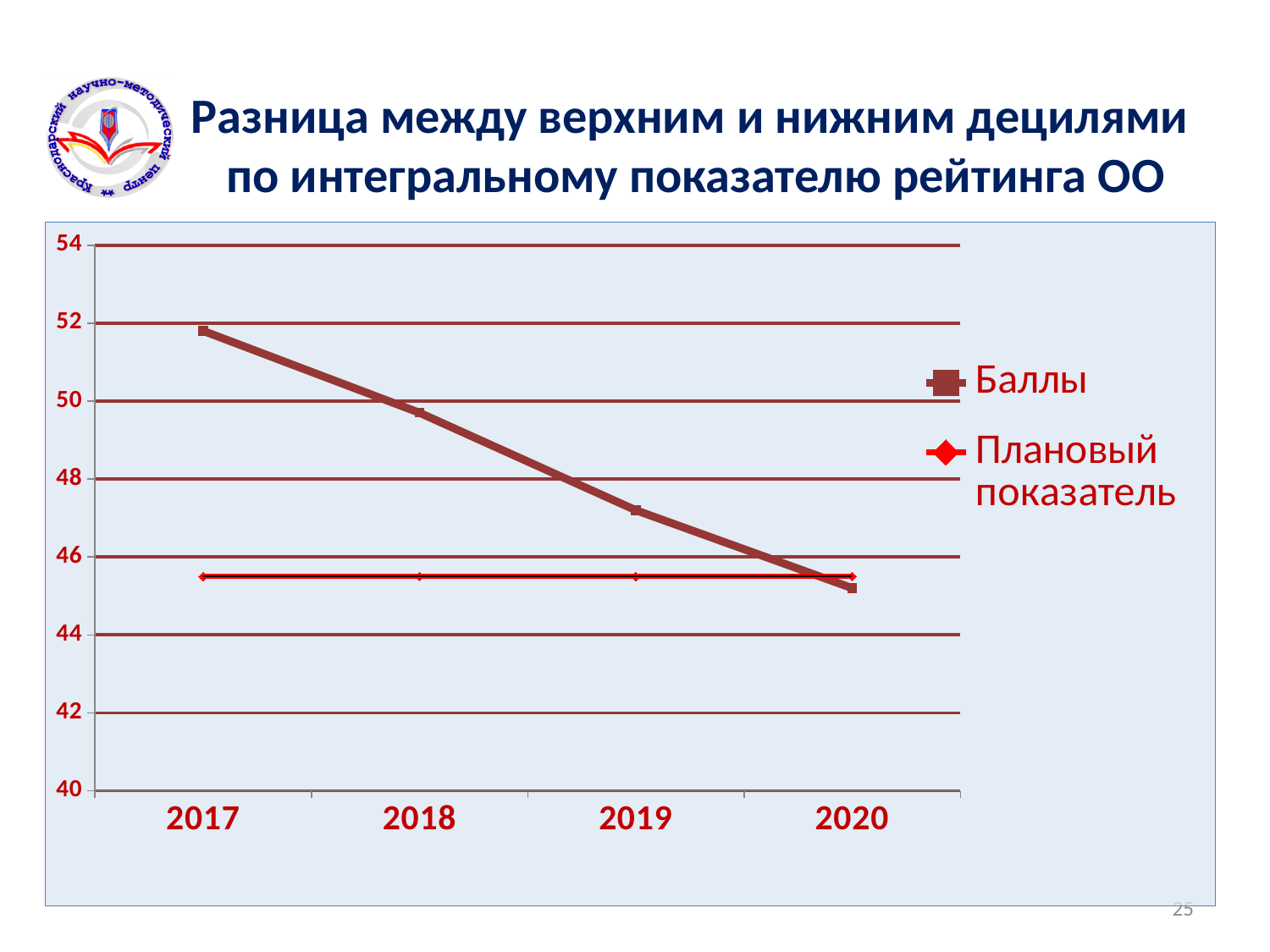
Is the Плановый показатель value for 2018 greater or less than 46? less In which year is the Баллы value lowest? 2020 In which year is the Баллы value highest? 2017 Is the Баллы value for 2019 greater or less than 48? less Is the Баллы value for 2017 greater or less than 50? greater How many series does the legend list? 2 Does the Баллы series rise or fall from 2017 to 2020? fall What kind of chart is shown on the slide? line chart How many years are shown on the x axis? 4 What is the first year shown on the x axis? 2017 Which series is drawn as a flat horizontal line across all years? Плановый показатель In 2018, which series has the larger value, Баллы or Плановый показатель? Баллы